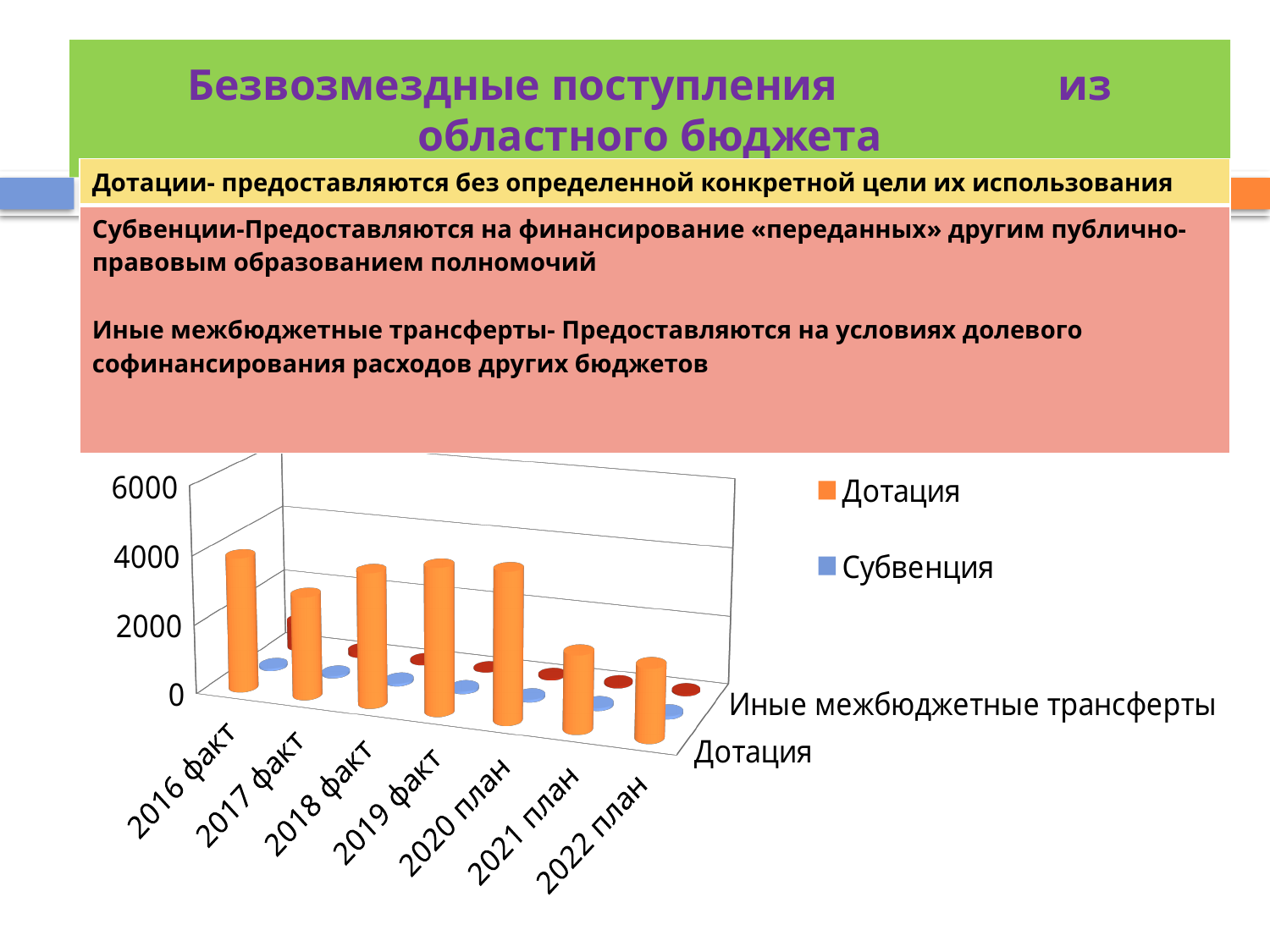
What colour represents the Дотация series in the chart? orange Do the Дотация values rise or fall from 2020 план to 2022 план? fall How many categories are shown along the x axis of the chart? 7 Is the Дотация value for 2019 факт greater or less than 2000? greater What kind of chart is shown on the slide? bar chart What is the title of the slide containing the chart? Безвозмездные поступления из областного бюджета Which is larger, the Дотация value for 2016 факт or for 2021 план? 2016 факт Which is larger, the Дотация value for 2019 факт or for 2022 план? 2019 факт Is the Дотация value for 2016 факт greater or less than 2000? greater How many series does the chart legend list? 2